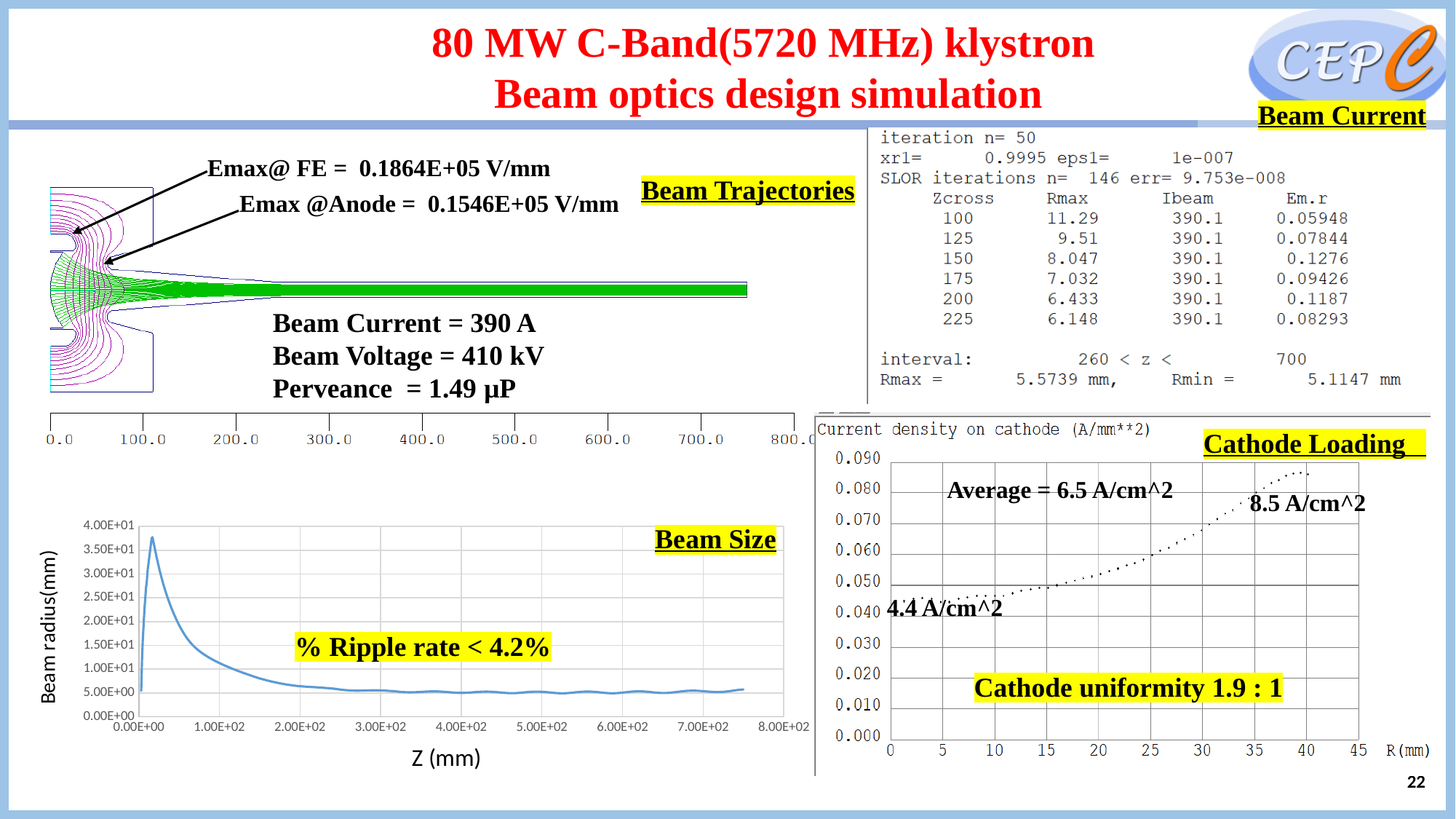
In the Cathode Loading chart, is the current density at R = 0 greater or less than 0.050? less In the Cathode Loading chart, what is the labelled average current density? 6.5 A/cm^2 In the Cathode Loading chart, what is the labelled maximum current density at the outer edge of the cathode? 8.5 A/cm^2 In the Beam Size chart, what is the y-axis title? Beam radius(mm) In the Beam Size chart, after the initial peak, does the beam radius rise or fall as Z increases? fall In the Cathode Loading chart, does the current density rise or fall as R increases? rise What kind of chart is the Beam Size chart? line chart In the Beam Size chart, what is the x-axis title? Z (mm) In the Beam Size chart, is the beam radius at Z = 4.00E+02 greater or less than 1.00E+01? less In the Cathode Loading chart, is the current density at R = 40 greater or less than 0.080? greater In the Beam Current table, what is Rmax at Zcross = 150? 8.047